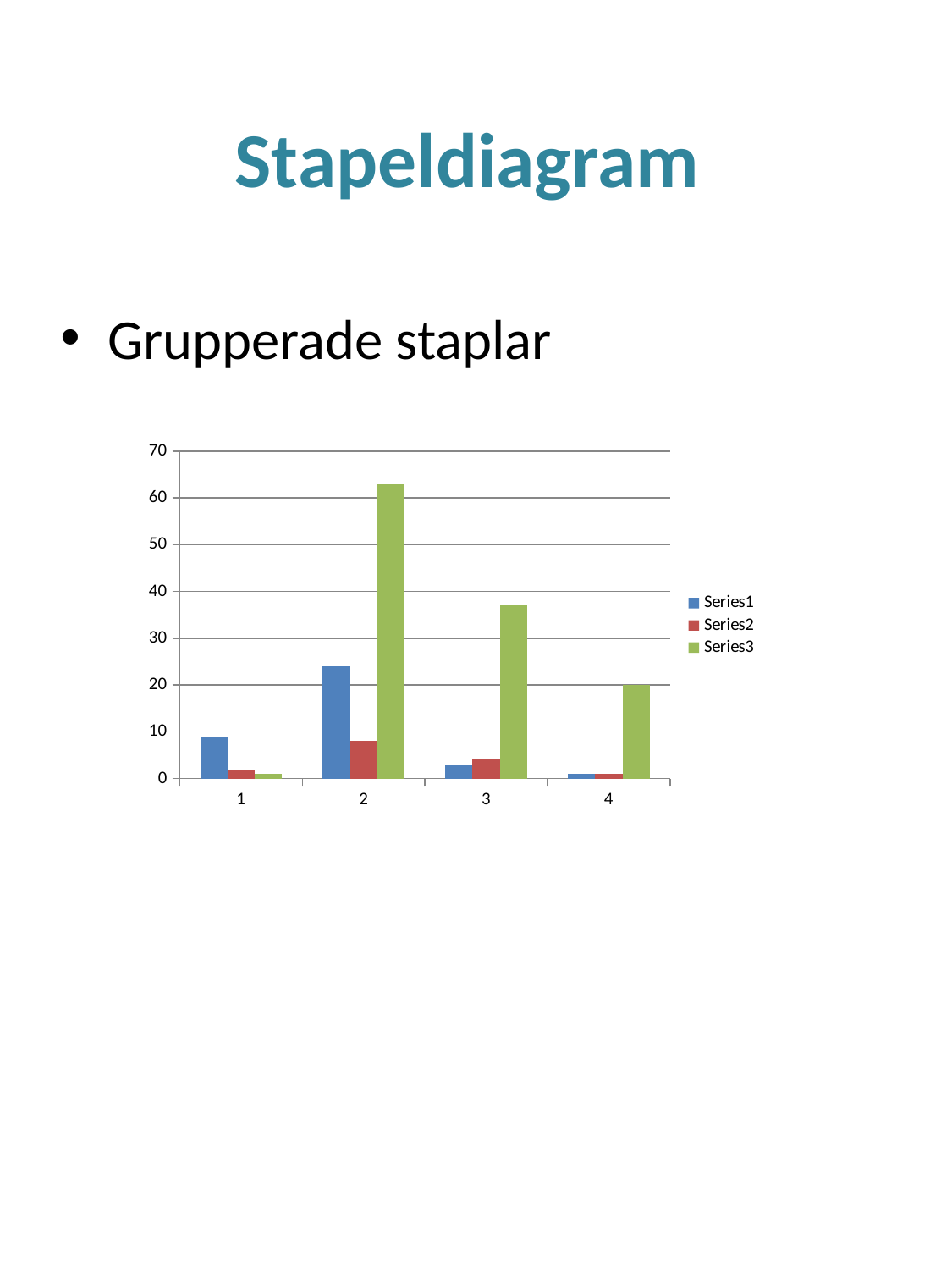
Which category has the lowest value for Series3? 1 How many series does the legend list? 3 Which category has the highest value for Series1? 2 Is the value for Series3 in category 3 greater or less than 40? less What kind of chart is shown on the slide? bar chart In category 3, which is larger: Series2 or Series3? Series3 Is the value for Series3 in category 2 greater or less than 60? greater How many categories are shown on the x axis of the chart? 4 Which category has the highest value for Series3? 2 In category 1, which is larger: Series1 or Series3? Series1 What colour are the bars for Series3? green Is the value for Series1 in category 2 greater or less than 20? greater